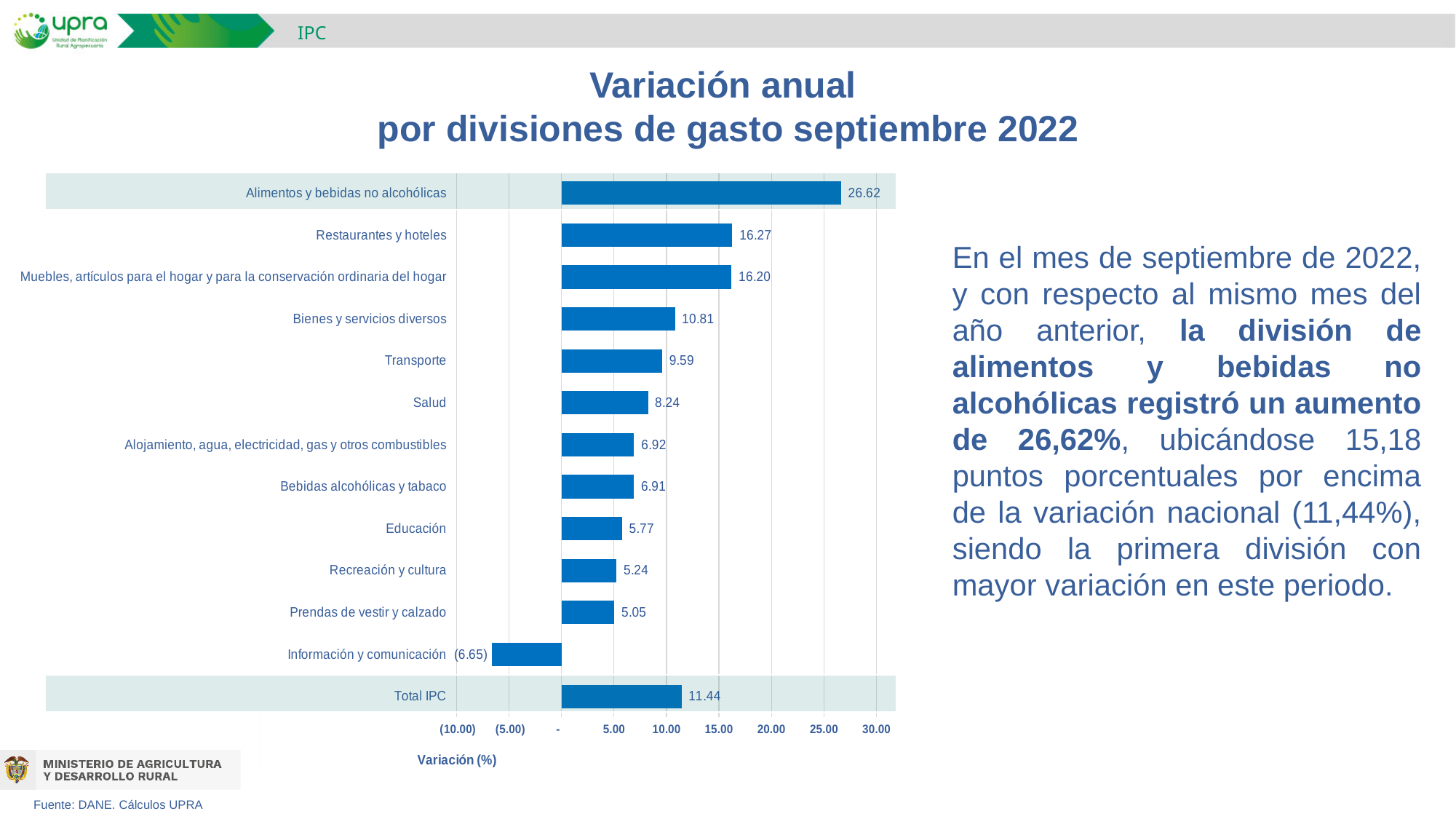
What kind of chart is shown on the slide? Bar chart What is the value for Total IPC? 11.44 How many categories are shown in the chart, including Total IPC? 13 Which category has the highest value? Alimentos y bebidas no alcohólicas Which is larger, the value for Salud or the value for Educación? Salud What is the value for Información y comunicación? (6.65) Which category has the lowest value? Información y comunicación What is the value for Transporte? 9.59 What is the difference between the values for Restaurantes y hoteles and Bienes y servicios diversos? 5.46 What is the label of the horizontal axis? Variación (%) Is the value for Alimentos y bebidas no alcohólicas greater or less than 25.00? greater What is the value for Alimentos y bebidas no alcohólicas? 26.62